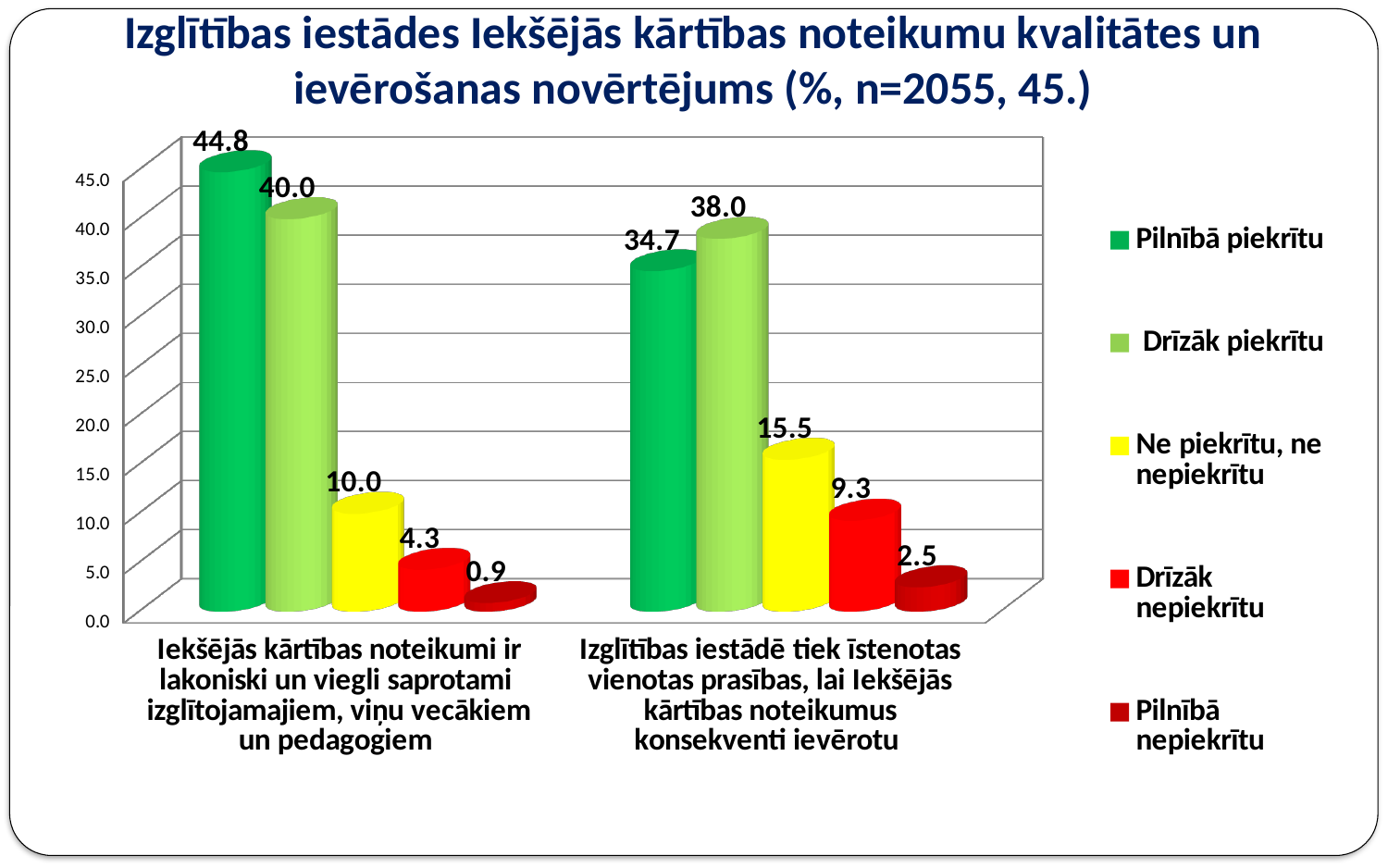
Which series has the lowest value in the category "Iekšējās kārtības noteikumi ir lakoniski un viegli saprotami izglītojamajiem, viņu vecākiem un pedagogiem"? Pilnībā nepiekrītu What is the difference between "Drīzāk nepiekrītu" and "Pilnībā nepiekrītu" in the category "Izglītības iestādē tiek īstenotas vienotas prasības, lai Iekšējās kārtības noteikumus konsekventi ievērotu"? 6.8 What is the difference between the "Pilnībā piekrītu" values of the two categories? 10.1 How many categories are shown on the x axis? 2 What is the value for "Pilnībā nepiekrītu" in the category "Iekšējās kārtības noteikumi ir lakoniski un viegli saprotami izglītojamajiem, viņu vecākiem un pedagogiem"? 0.9 Which category has the larger value for "Drīzāk nepiekrītu"? Izglītības iestādē tiek īstenotas vienotas prasības, lai Iekšējās kārtības noteikumus konsekventi ievērotu How many series does the legend list? 5 What kind of chart is shown on the slide? Bar chart What is the value for "Drīzāk piekrītu" in the category "Izglītības iestādē tiek īstenotas vienotas prasības, lai Iekšējās kārtības noteikumus konsekventi ievērotu"? 38.0 What is the value for "Pilnībā piekrītu" in the category "Iekšējās kārtības noteikumi ir lakoniski un viegli saprotami izglītojamajiem, viņu vecākiem un pedagogiem"? 44.8 Which series has the highest value in the category "Izglītības iestādē tiek īstenotas vienotas prasības, lai Iekšējās kārtības noteikumus konsekventi ievērotu"? Drīzāk piekrītu What is the value for "Ne piekrītu, ne nepiekrītu" in the category "Izglītības iestādē tiek īstenotas vienotas prasības, lai Iekšējās kārtības noteikumus konsekventi ievērotu"? 15.5